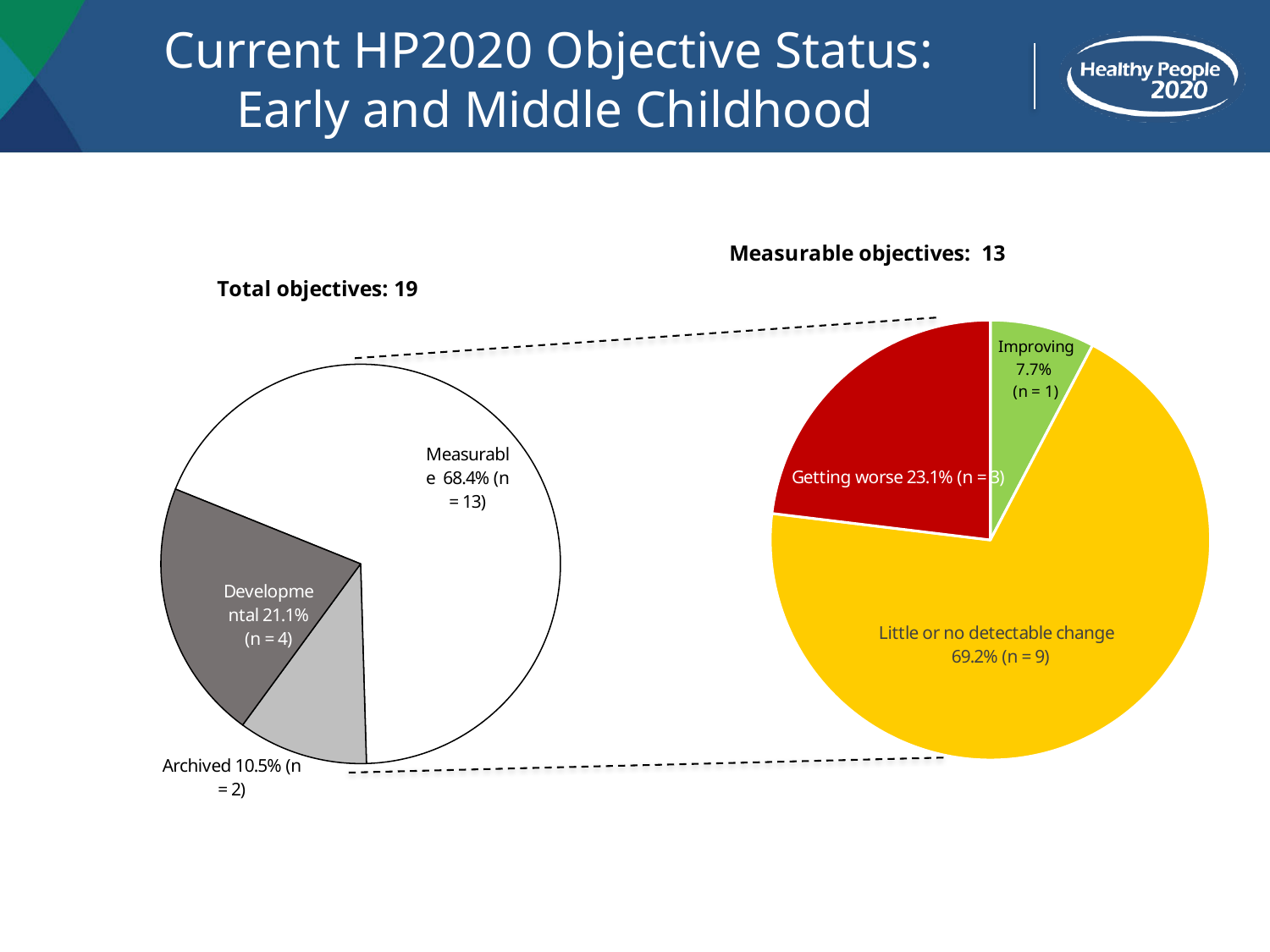
In the right pie chart (Measurable objectives), what is the total number of measurable objectives stated above the chart? 13 In the right pie chart (Measurable objectives), which is larger: the Improving share or the Getting worse share? Getting worse In the right pie chart (Measurable objectives), how many objectives show Little or no detectable change? 9 In the right pie chart (Measurable objectives), what colour is the Improving slice? Green In the left pie chart (Total objectives), what percentage of objectives are Measurable? 68.4% In the right pie chart (Measurable objectives), what percentage of objectives are Getting worse? 23.1% In the left pie chart (Total objectives), what is the difference in percentage points between the Measurable and Developmental shares? 47.3 In the right pie chart (Measurable objectives), which category has the largest share? Little or no detectable change What type of chart is used on the left side of the slide for total objectives? Pie chart In the left pie chart (Total objectives), how many objectives are Developmental? 4 In the left pie chart (Total objectives), which category has the smallest share? Archived In the left pie chart (Total objectives), how many categories are shown? 3